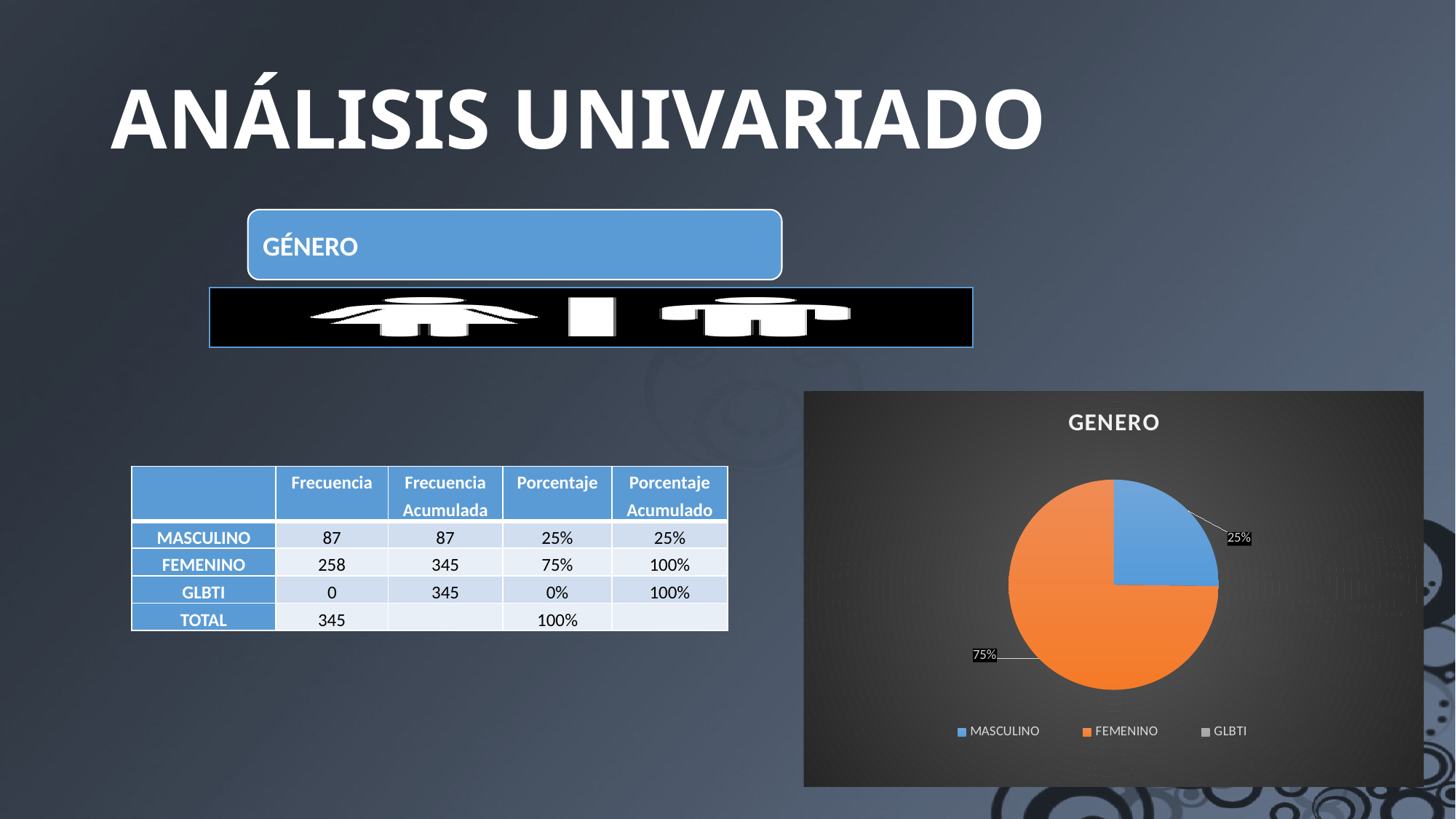
Is the share for MASCULINO greater or less than 50%? less What share of the pie does FEMENINO represent? 75% Which category has the largest slice of the pie? FEMENINO What kind of chart is shown on the slide? pie chart What is the title of the chart? GENERO What is the difference in percentage points between the FEMENINO and MASCULINO slices? 50% Which colour represents FEMENINO in the pie chart? orange Which of MASCULINO or FEMENINO has the larger slice? FEMENINO How many entries does the chart legend list? 3 What share of the pie does MASCULINO represent? 25%